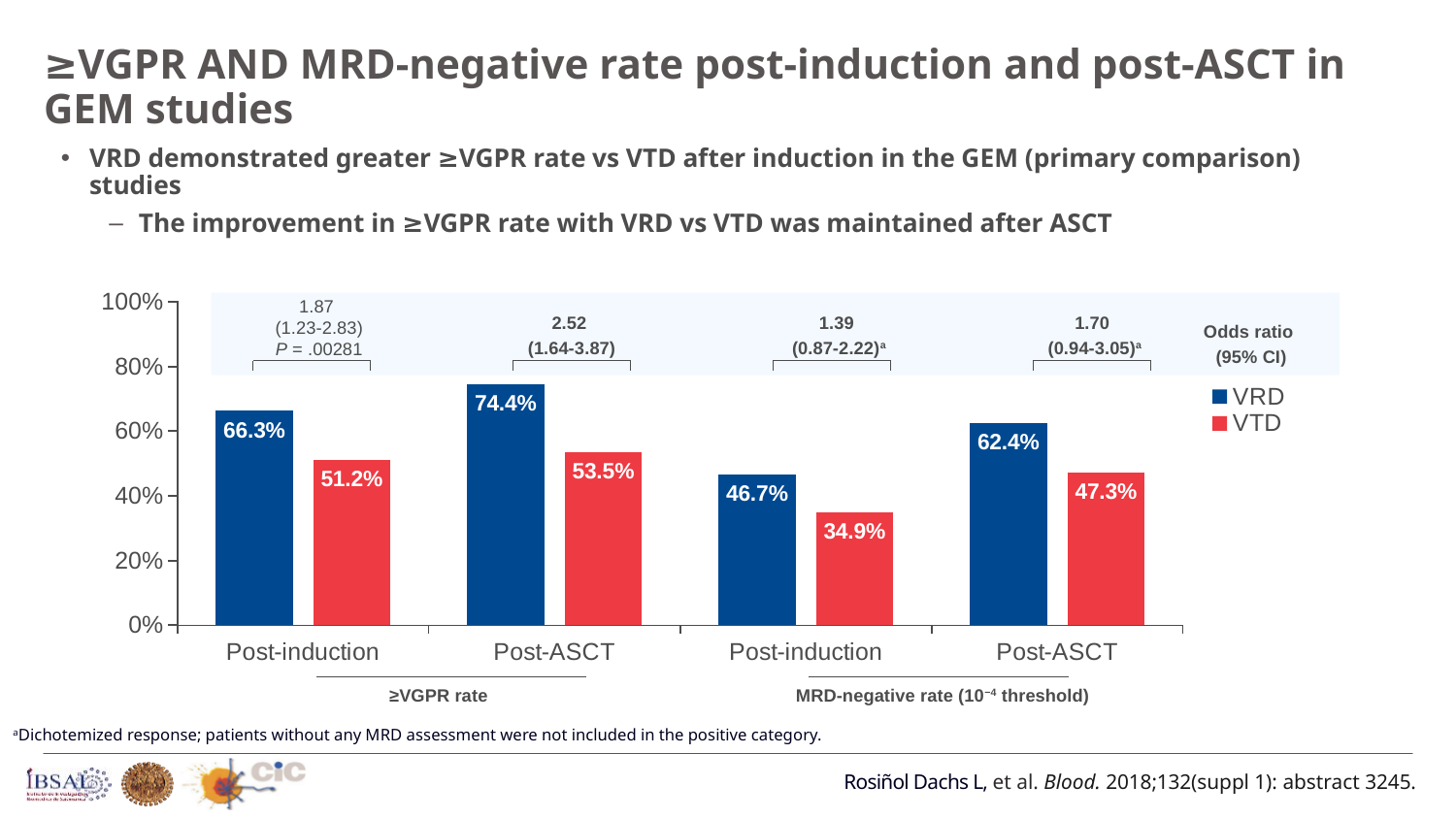
What is the odds ratio shown above the Post-ASCT bars in the ≥VGPR rate group? 2.52 (1.64-3.87) What is the VTD value for Post-induction in the MRD-negative rate group? 34.9% Is the VRD value for Post-induction in the MRD-negative rate group greater or less than 40%? greater What kind of chart is shown on the slide? Bar chart How many series does the legend list? 2 Which bar has the lowest value on the chart? VTD, Post-induction (MRD-negative rate), 34.9% Which bar has the highest value on the chart? VRD, Post-ASCT (≥VGPR rate), 74.4% What is the VTD value for Post-ASCT in the ≥VGPR rate group? 53.5% What is the VRD value for Post-ASCT in the MRD-negative rate group? 62.4% What is the difference between the VRD and VTD values for Post-induction in the ≥VGPR rate group? 15.1 percentage points Which is larger for Post-ASCT in the MRD-negative rate group, VRD or VTD? VRD What is the VRD value for Post-induction in the ≥VGPR rate group? 66.3%